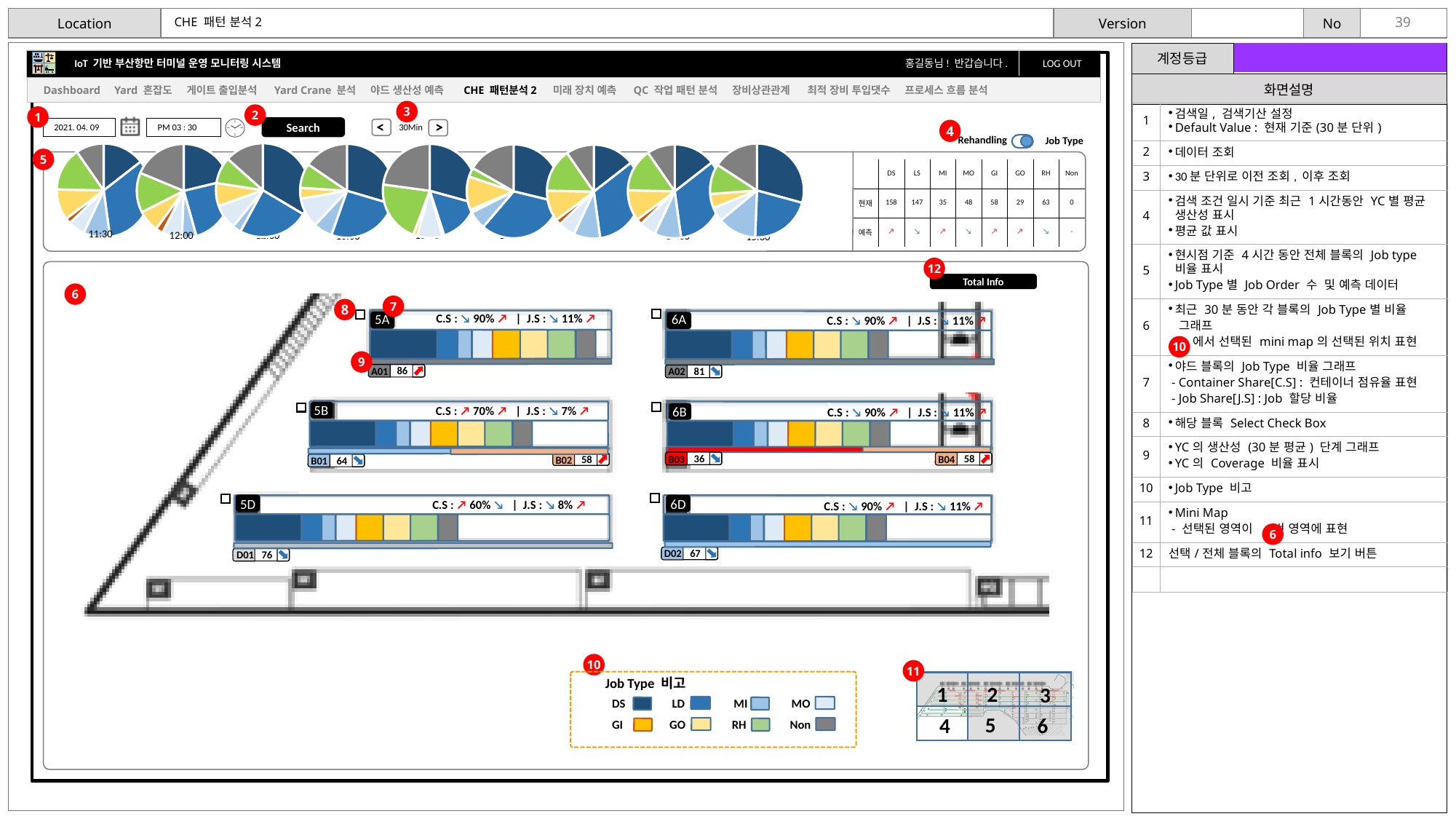
How many pie charts are shown in the row at the top of the dashboard? 9 How many job types does the 'Job Type 비고' legend list? 8 In the table to the right of the pie charts, which job type has the highest 현재 (current) value? DS In the table to the right of the pie charts, which has the larger 현재 value, MI or MO? MO In the table to the right of the pie charts, what is the 현재 (current) value for RH? 63 In the table to the right of the pie charts, what is the 현재 (current) value for DS? 158 In the table to the right of the pie charts, which job type has the lowest 현재 (current) value? Non What kind of charts are shown in the row of time-series charts at the top of the dashboard (labelled 5)? pie charts What value is shown for YC B03 below the 6B block chart? 36 In the table to the right of the pie charts, what is the difference between the 현재 values for DS and LS? 11 In the block chart for 5B, what C.S percentage is shown? 70% In the block chart for 5D, what J.S percentage is shown? 8%